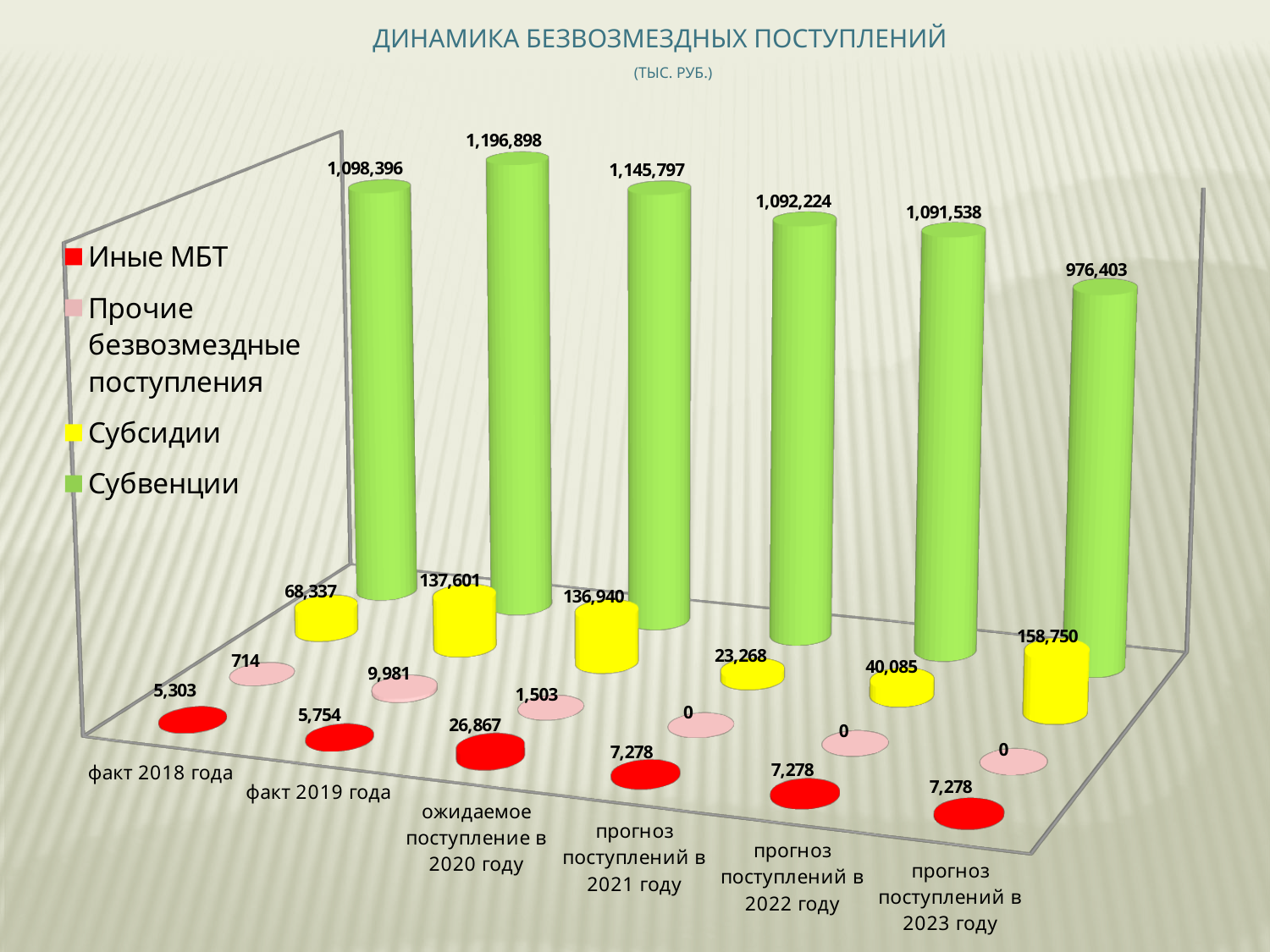
How many series does the legend list? 4 What is the value of Иные МБТ for ожидаемое поступление в 2020 году? 26,867 In which category is the Субсидии value lowest? прогноз поступлений в 2021 году In which category is the Субвенции value highest? факт 2019 года What is the difference between the Субвенции values for факт 2019 года and прогноз поступлений в 2023 году? 220,495 What is the value of Субвенции for факт 2019 года? 1,196,898 In which category is the Субвенции value lowest? прогноз поступлений в 2023 году How many categories are shown on the x axis? 6 What type of chart is shown on the slide? bar chart Which is larger: Субсидии for факт 2019 года or Субсидии for ожидаемое поступление в 2020 году? факт 2019 года What is the value of Прочие безвозмездные поступления for факт 2019 года? 9,981 What is the value of Субсидии for прогноз поступлений в 2023 году? 158,750